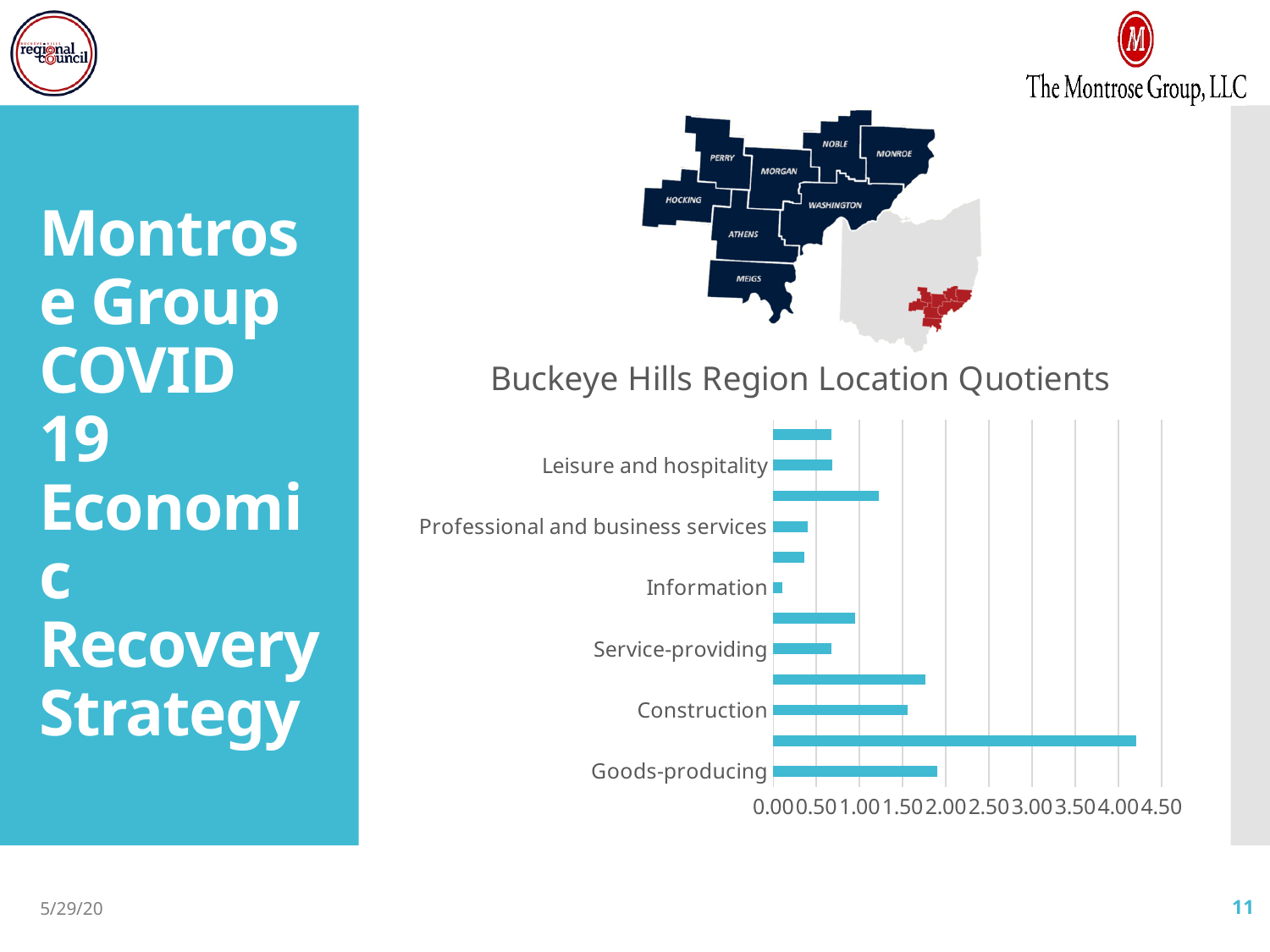
Is the value for Construction greater or less than 1.00? greater What is the title of the chart? Buckeye Hills Region Location Quotients Is the value for Information greater or less than 0.50? less What is the highest value shown on the x axis? 4.50 What kind of chart is shown on the slide? bar chart Which has the larger value, Goods-producing or Construction? Goods-producing Is the value for Service-providing greater or less than 1.00? less Which has the larger value, Information or Service-providing? Service-providing Which of the labeled categories has the lowest value? Information